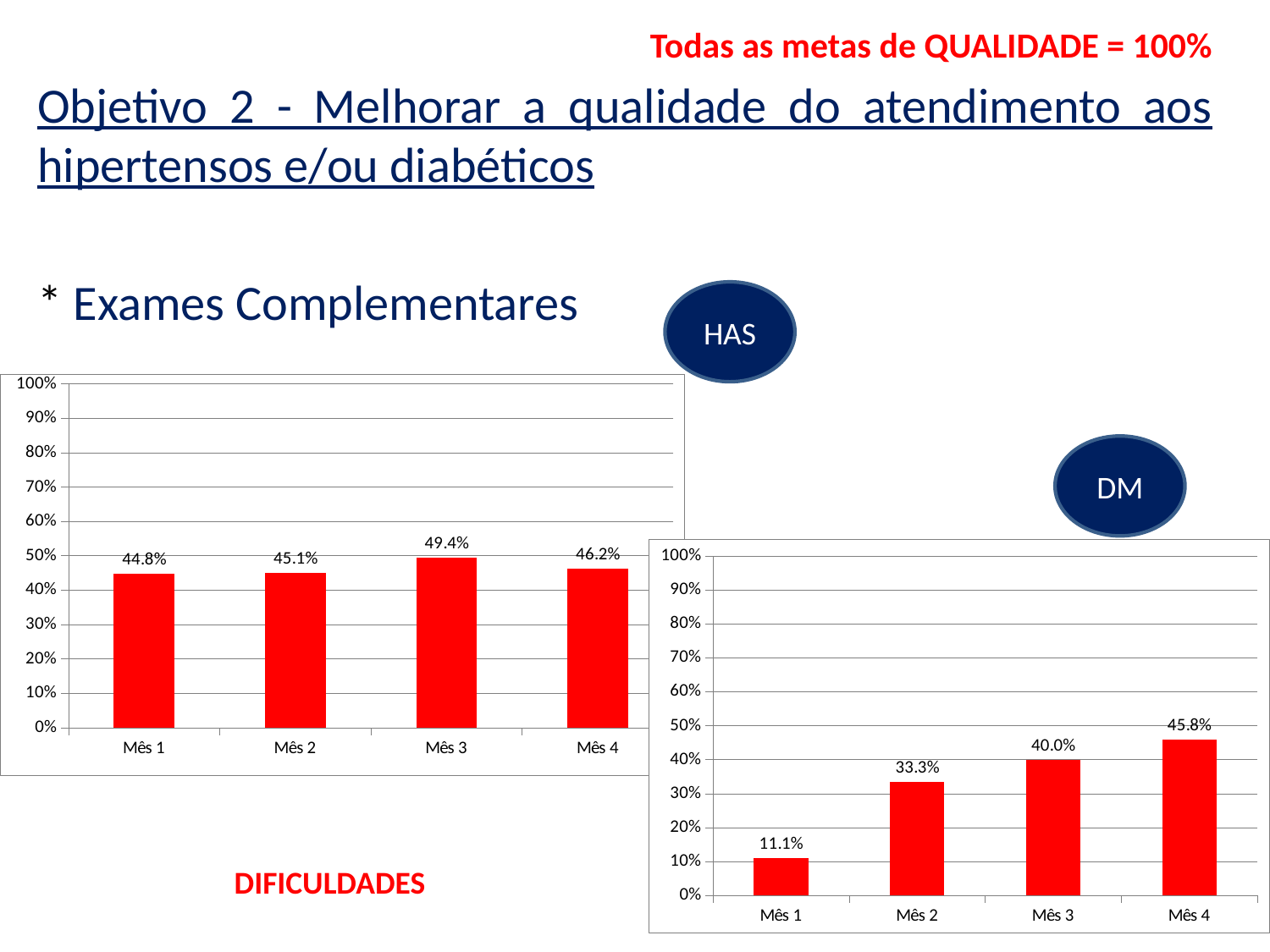
In the HAS chart (left), what is the difference between Mês 3 and Mês 1? 4.6% In the DM chart (right), do the values rise or fall from Mês 1 to Mês 4? rise What kind of chart is the HAS chart (left)? bar chart In the DM chart (right), what is the difference between Mês 4 and Mês 1? 34.7% In the HAS chart (left), which month has the highest value? Mês 3 In the HAS chart (left), what is the value for Mês 3? 49.4% In the HAS chart (left), is the value for Mês 2 greater or less than 50%? less In the DM chart (right), what is the value for Mês 4? 45.8% In the DM chart (right), which is larger, Mês 2 or Mês 3? Mês 3 In the DM chart (right), which month has the lowest value? Mês 1 In the DM chart (right), what is the value for Mês 1? 11.1% How many months are shown on the x axis of the DM chart (right)? 4